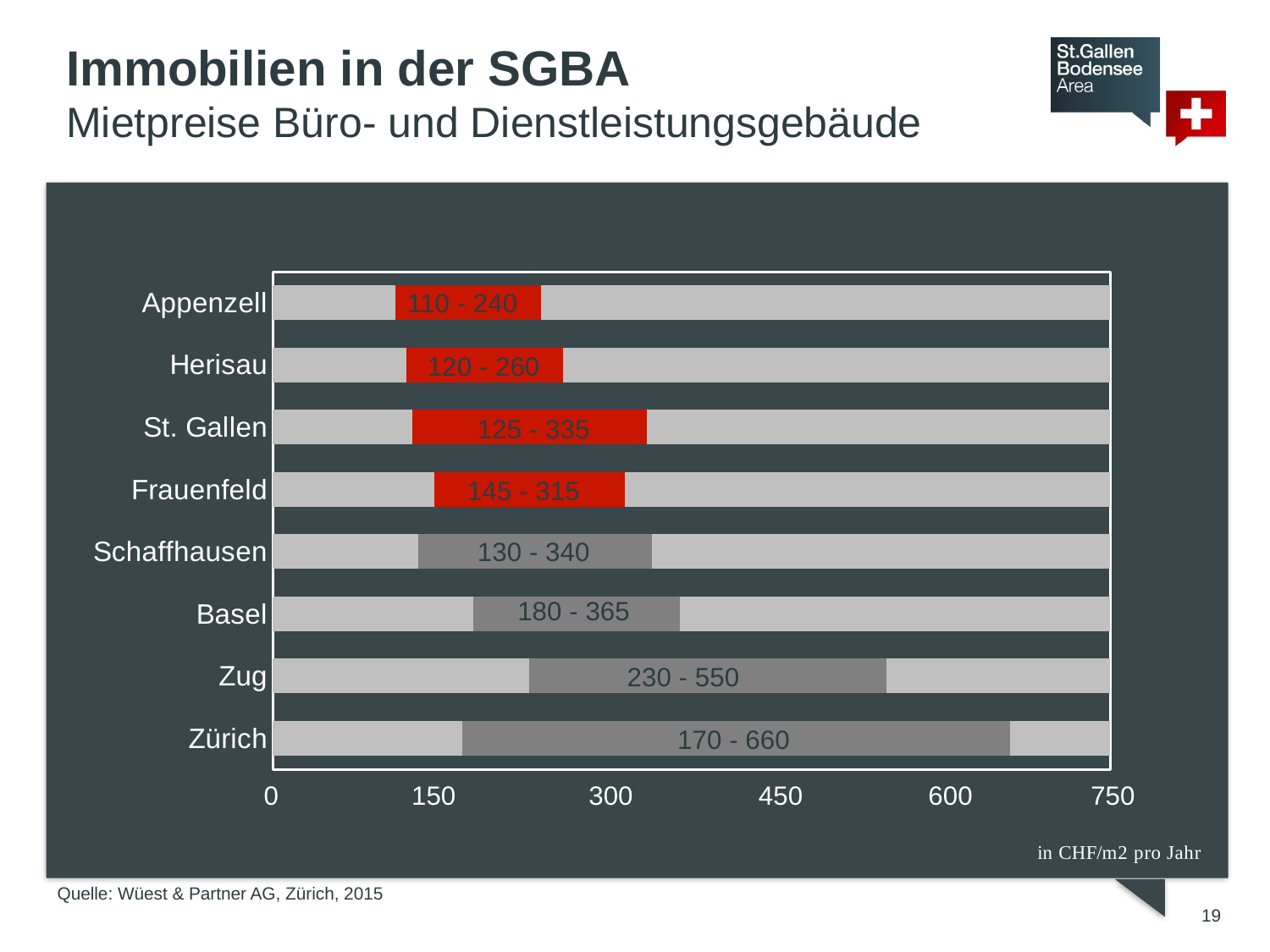
What is the highest value shown on the x axis? 750 How many cities are shown in the chart? 8 Which city has a higher upper end of its rent price range, Schaffhausen or Herisau? Schaffhausen In what unit are the values in the chart given? CHF/m2 pro Jahr What kind of chart is shown on the slide? bar chart What rent price range is shown for Appenzell? 110 - 240 Which city has the lowest lower end of its rent price range? Appenzell What rent price range is shown for Zürich? 170 - 660 What is the difference between the upper end of the range for Zug and the upper end of the range for Basel? 185 Which city has the highest upper end of its rent price range? Zürich What rent price range is shown for St. Gallen? 125 - 335 Is the upper end of the range for Zug greater or less than 450? greater